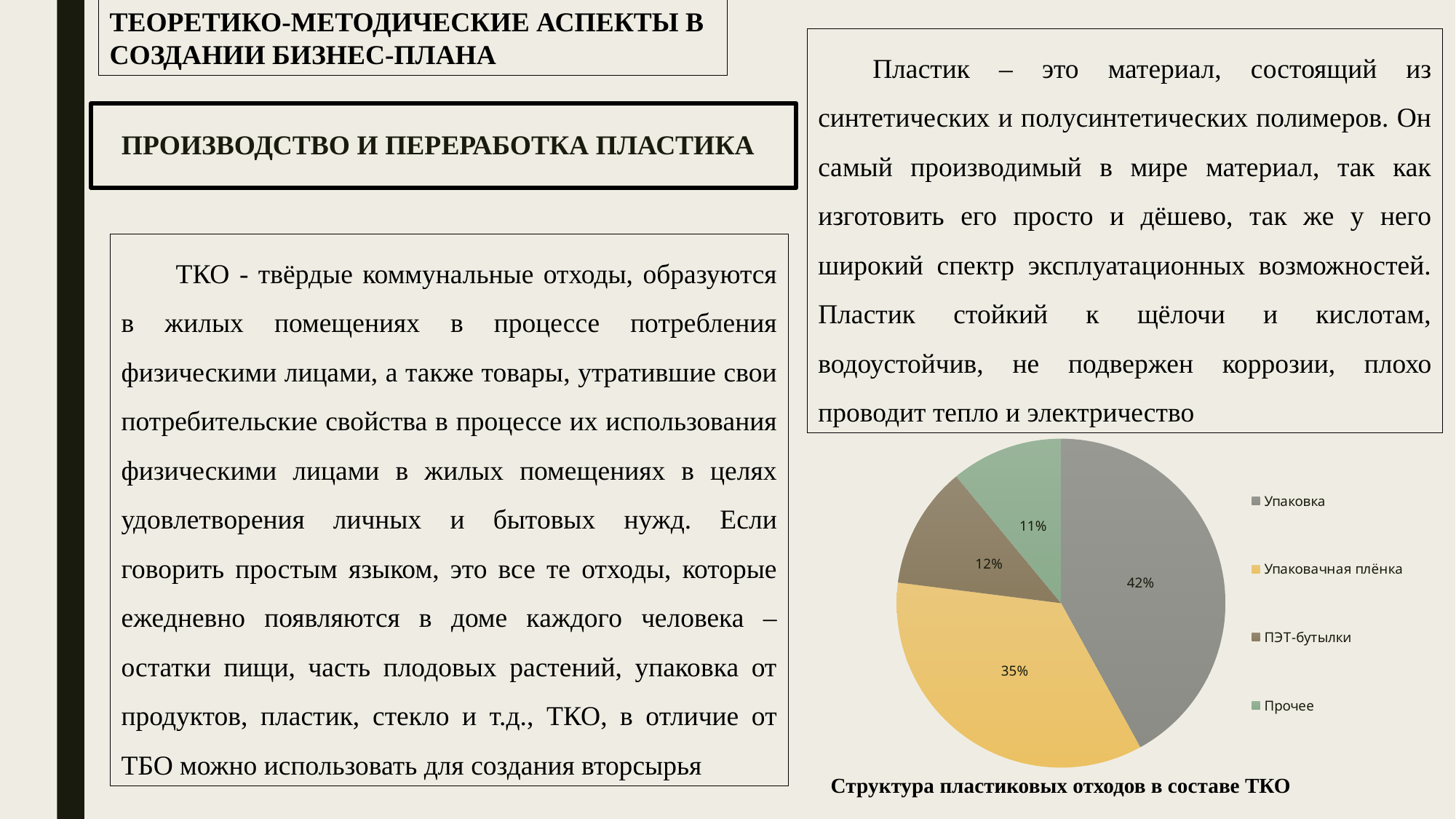
Which is larger in the pie chart: ПЭТ-бутылки or Прочее? ПЭТ-бутылки What share of the pie chart does Упаковачная плёнка account for? 35% What is the difference in percentage points between Упаковка and Упаковачная плёнка? 7 Which category has the smallest slice in the pie chart? Прочее What share of the pie chart does ПЭТ-бутылки account for? 12% What share of the pie chart does Прочее account for? 11% What is the caption of the pie chart? Структура пластиковых отходов в составе ТКО What colour is the slice for Упаковачная плёнка in the pie chart? yellow How many categories are shown in the pie chart? 4 What type of chart is shown on the slide? pie chart What share of the pie chart does Упаковка account for? 42% Which category has the largest slice in the pie chart? Упаковка